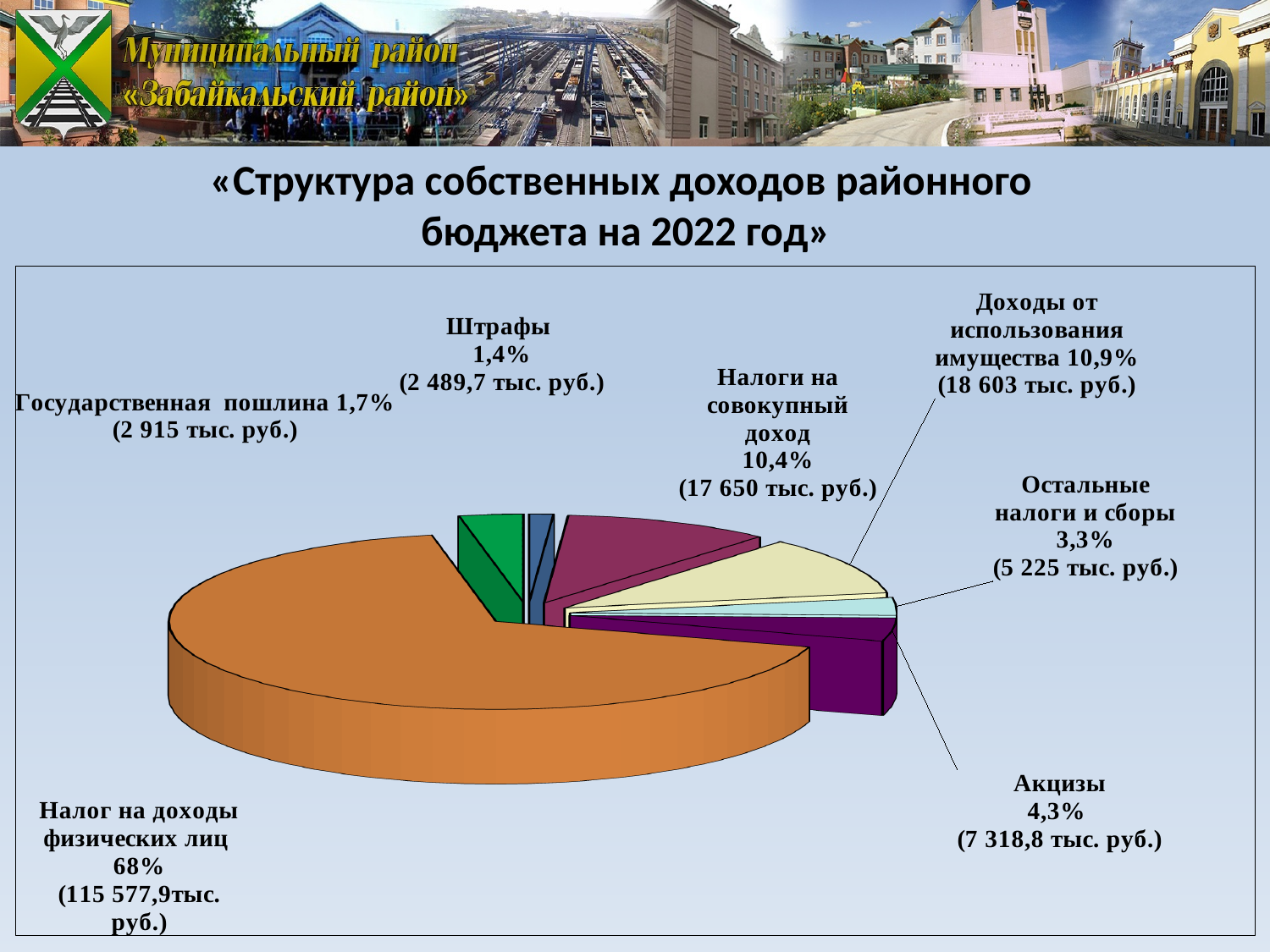
Which is larger: the share for «Налоги на совокупный доход» or for «Доходы от использования имущества»? Доходы от использования имущества Which category has the smallest share of the pie? Штрафы What kind of chart is shown on the slide? Pie chart Which category has the largest share of the pie? Налог на доходы физических лиц What is the title of the slide's chart? «Структура собственных доходов районного бюджета на 2022 год» What is the difference in percentage points between «Акцизы» and «Остальные налоги и сборы»? 1 percentage point What is the amount shown for «Штрафы»? 2 489,7 тыс. руб. What share of the pie does «Налог на доходы физических лиц» represent? 68% How many categories (slices) does the pie chart have? 7 What percentage is shown for «Акцизы»? 4,3% What is the percentage shown for «Государственная пошлина»? 1,7% What is the amount shown for «Доходы от использования имущества»? 18 603 тыс. руб.